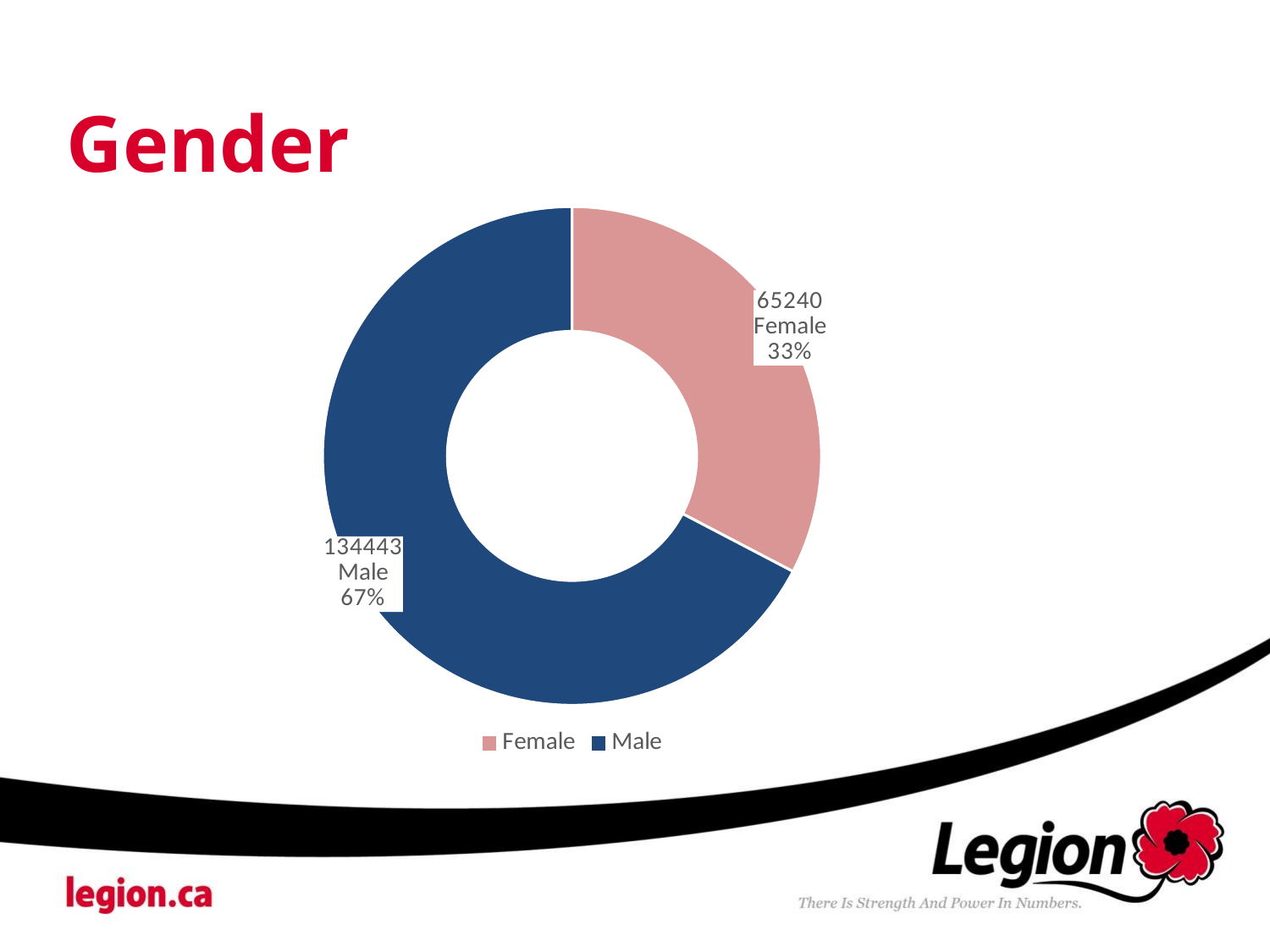
What is the value for Male? 134443 What share of the chart does the Male slice represent? 67% What is the difference between the Male and Female values? 69203 Which category has the largest share of the chart? Male How many entries does the legend list? 2 What is the value for Female? 65240 What is the title of the slide containing the chart? Gender How many categories are shown in the chart? 2 Which is larger, the value for Male or the value for Female? Male What kind of chart is shown on the slide? Pie chart (doughnut) What share of the chart does the Female slice represent? 33% Which category has the smallest share of the chart? Female